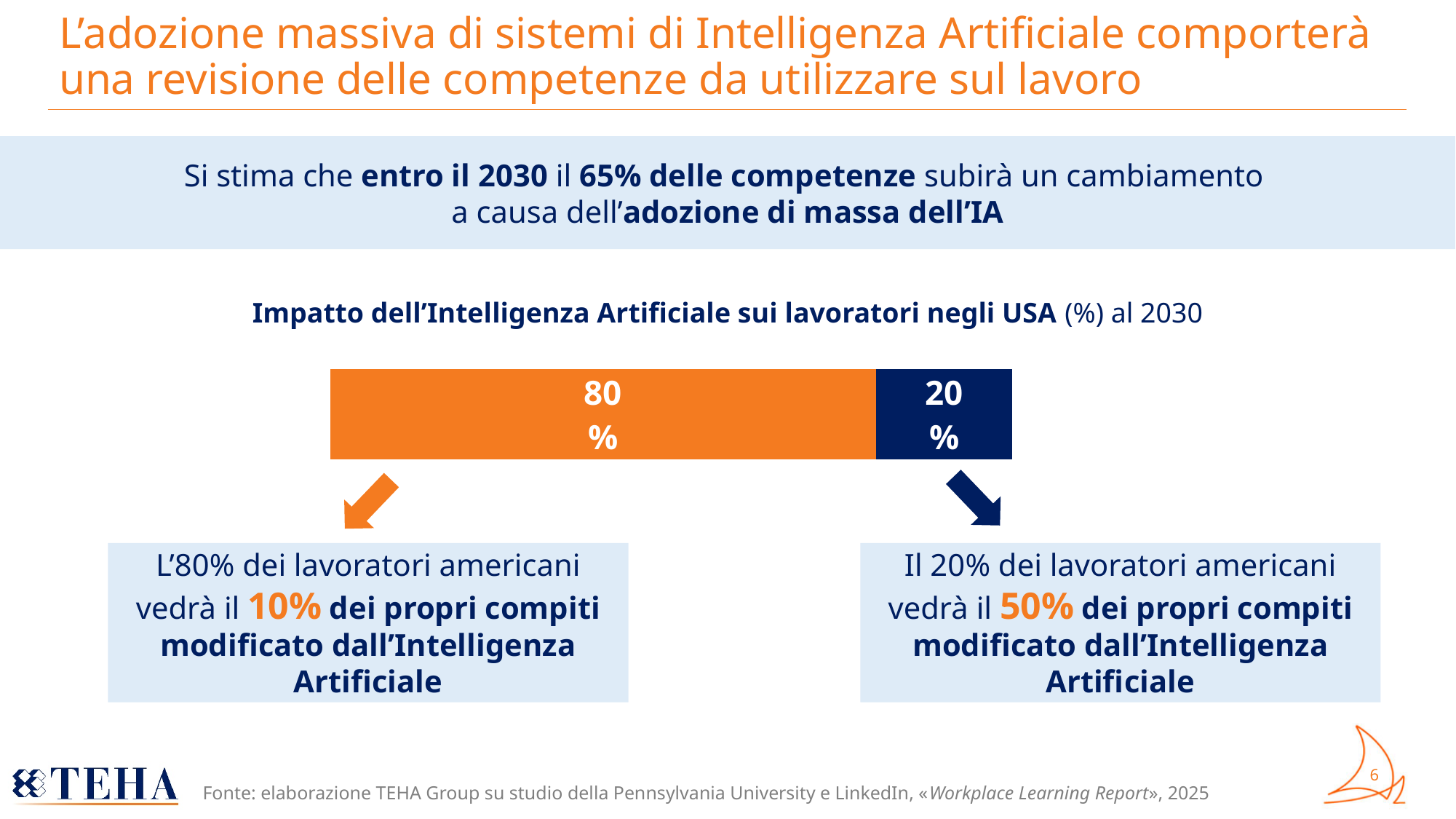
How many segments does the stacked bar contain? 2 What is the title of the chart on the slide? Impatto dell'Intelligenza Artificiale sui lavoratori negli USA (%) al 2030 What kind of chart is shown on the slide? Stacked bar chart What value is printed on the orange segment of the bar? 80% What value is printed on the dark blue segment of the bar? 20% What is the difference between the two segment values shown on the bar? 60% Which segment of the bar is larger, the orange one or the dark blue one? The orange one What colour is the segment representing 80% of American workers? Orange According to the slide, what share of their tasks will the 20% of American workers see modified by AI? 50% What is the total of the two segments of the stacked bar? 100% According to the slide, what share of their tasks will the 80% of American workers see modified by AI? 10% Which segment of the bar has the smallest value? The dark blue segment (20%)